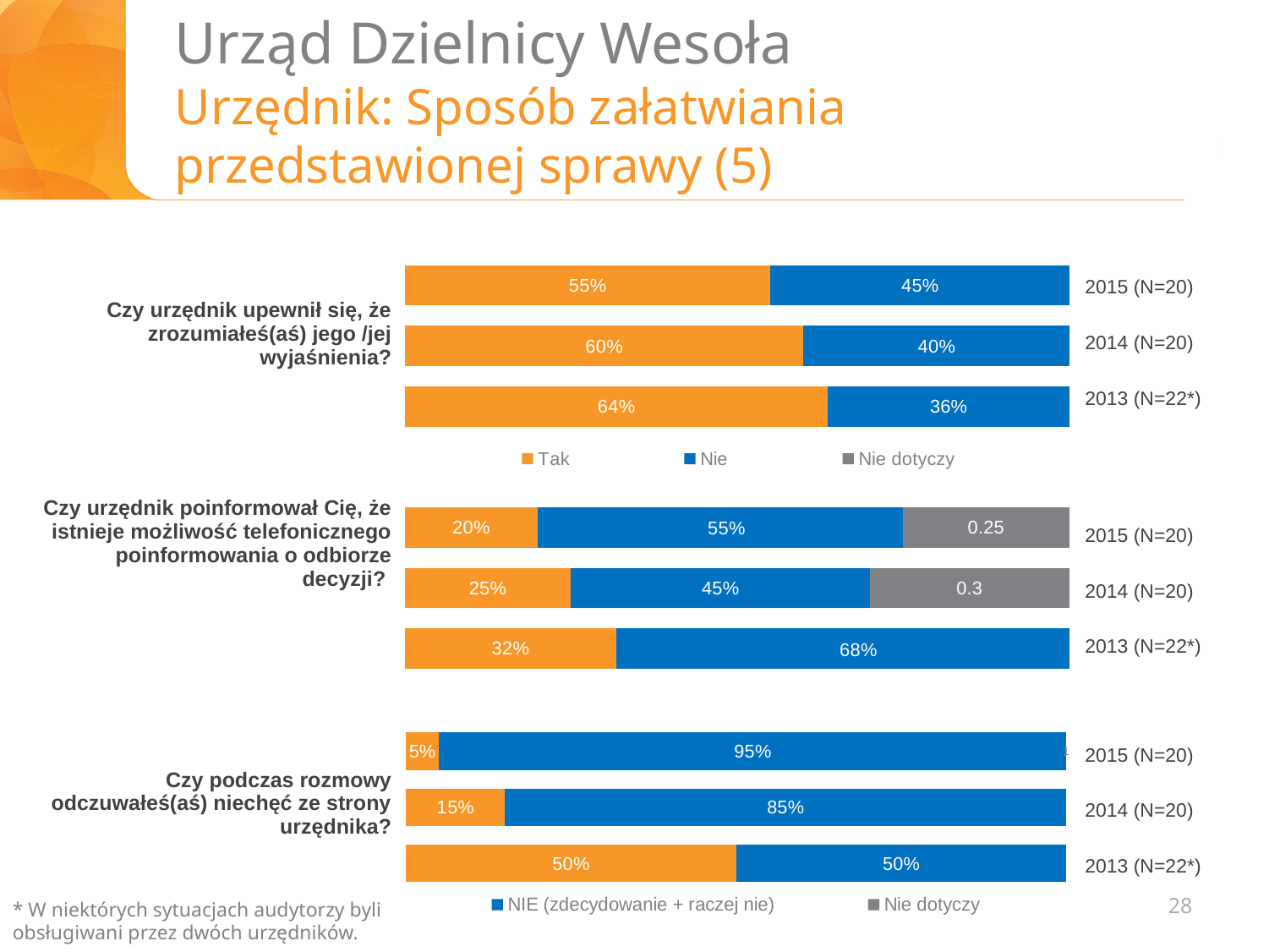
In the chart for "Czy urzędnik poinformował Cię, że istnieje możliwość telefonicznego poinformowania o odbiorze decyzji?", what is the "Nie dotyczy" value for 2014 (N=20)? 0.3 In the chart for "Czy podczas rozmowy odczuwałeś(aś) niechęć ze strony urzędnika?", which year has the highest "NIE (zdecydowanie + raczej nie)" value? 2015 (N=20) What type of chart is used for "Czy podczas rozmowy odczuwałeś(aś) niechęć ze strony urzędnika?"? Stacked bar chart In the chart for "Czy urzędnik upewnił się, że zrozumiałeś(aś) jego /jej wyjaśnienia?", which year has the highest "Tak" value? 2013 (N=22*) In the chart for "Czy urzędnik poinformował Cię, że istnieje możliwość telefonicznego poinformowania o odbiorze decyzji?", what is the "Nie" value for 2013 (N=22*)? 68% In the chart for "Czy urzędnik upewnił się, że zrozumiałeś(aś) jego /jej wyjaśnienia?", what is the "Tak" value for 2015 (N=20)? 55% In the chart for "Czy urzędnik upewnił się, że zrozumiałeś(aś) jego /jej wyjaśnienia?", what is the "Nie" value for 2013 (N=22*)? 36% In the chart for "Czy podczas rozmowy odczuwałeś(aś) niechęć ze strony urzędnika?", how many year bars are shown? 3 In the chart for "Czy urzędnik poinformował Cię, że istnieje możliwość telefonicznego poinformowania o odbiorze decyzji?", which year has the lowest "Tak" value? 2015 (N=20) In the chart for "Czy urzędnik upewnił się, że zrozumiałeś(aś) jego /jej wyjaśnienia?", how many series does the legend list? 3 In the chart for "Czy podczas rozmowy odczuwałeś(aś) niechęć ze strony urzędnika?", what is the "NIE (zdecydowanie + raczej nie)" value for 2015 (N=20)? 95% In the chart for "Czy urzędnik poinformował Cię, że istnieje możliwość telefonicznego poinformowania o odbiorze decyzji?", what is the difference between the "Nie" values for 2015 (N=20) and 2014 (N=20)? 10%